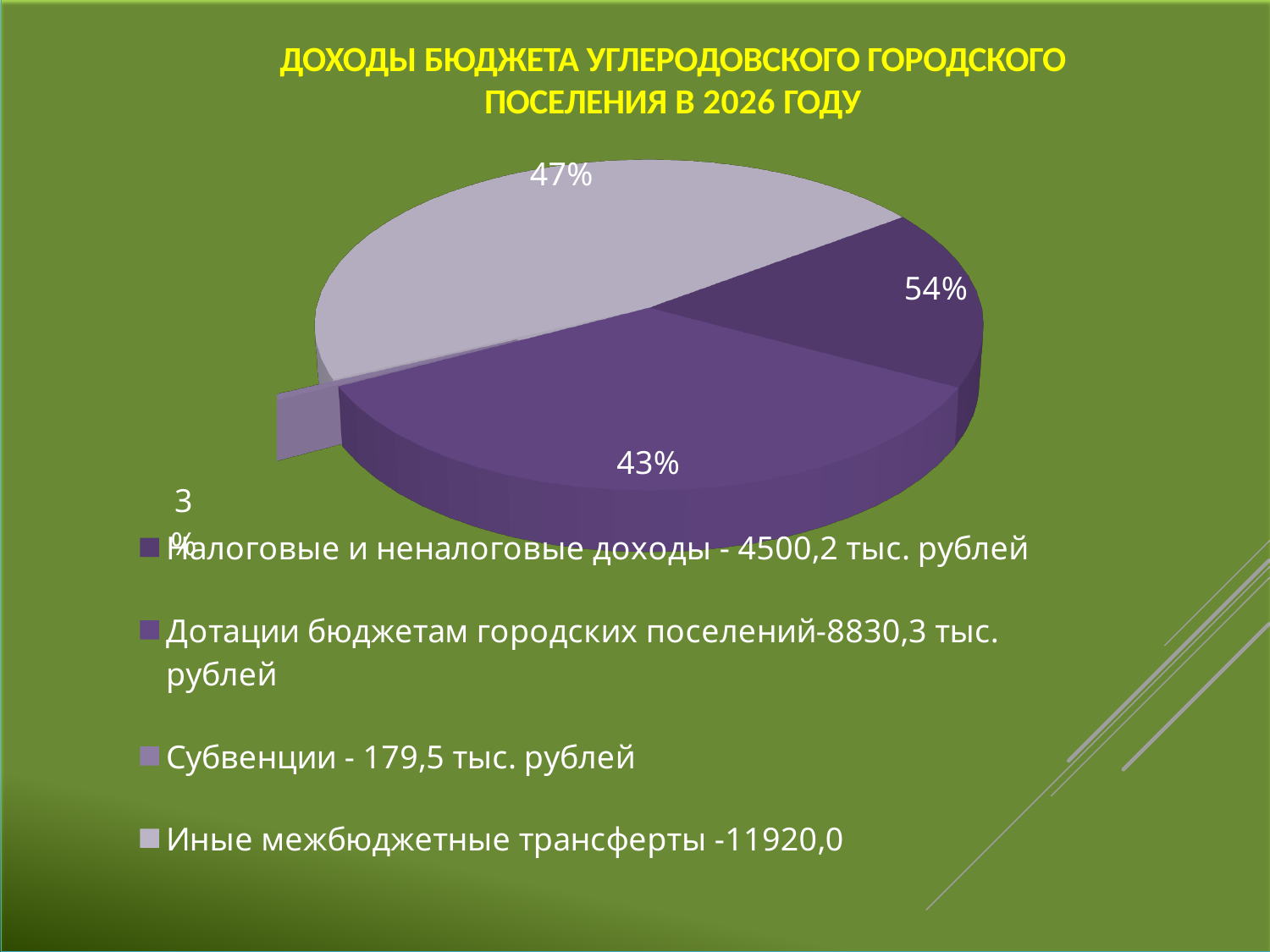
What percentage label is shown on the medium purple slice (Дотации бюджетам городских поселений)? 43% Is the share labelled on the Субвенции slice greater or less than 10%? less What percentage label is shown on the grey slice (Иные межбюджетные трансферты)? 47% How many slices does the pie chart have? 4 What year does the chart title refer to? 2026 What percentage label is shown on the dark purple slice (Налоговые и неналоговые доходы)? 54% What kind of chart is shown on the slide? pie chart Which legend entry corresponds to the slice labelled 3%? Субвенции - 179,5 тыс. рублей What percentage label is shown on the smallest slice of the pie chart? 3% What amount is listed in the legend for Налоговые и неналоговые доходы? 4500,2 тыс. рублей How many entries does the legend list? 4